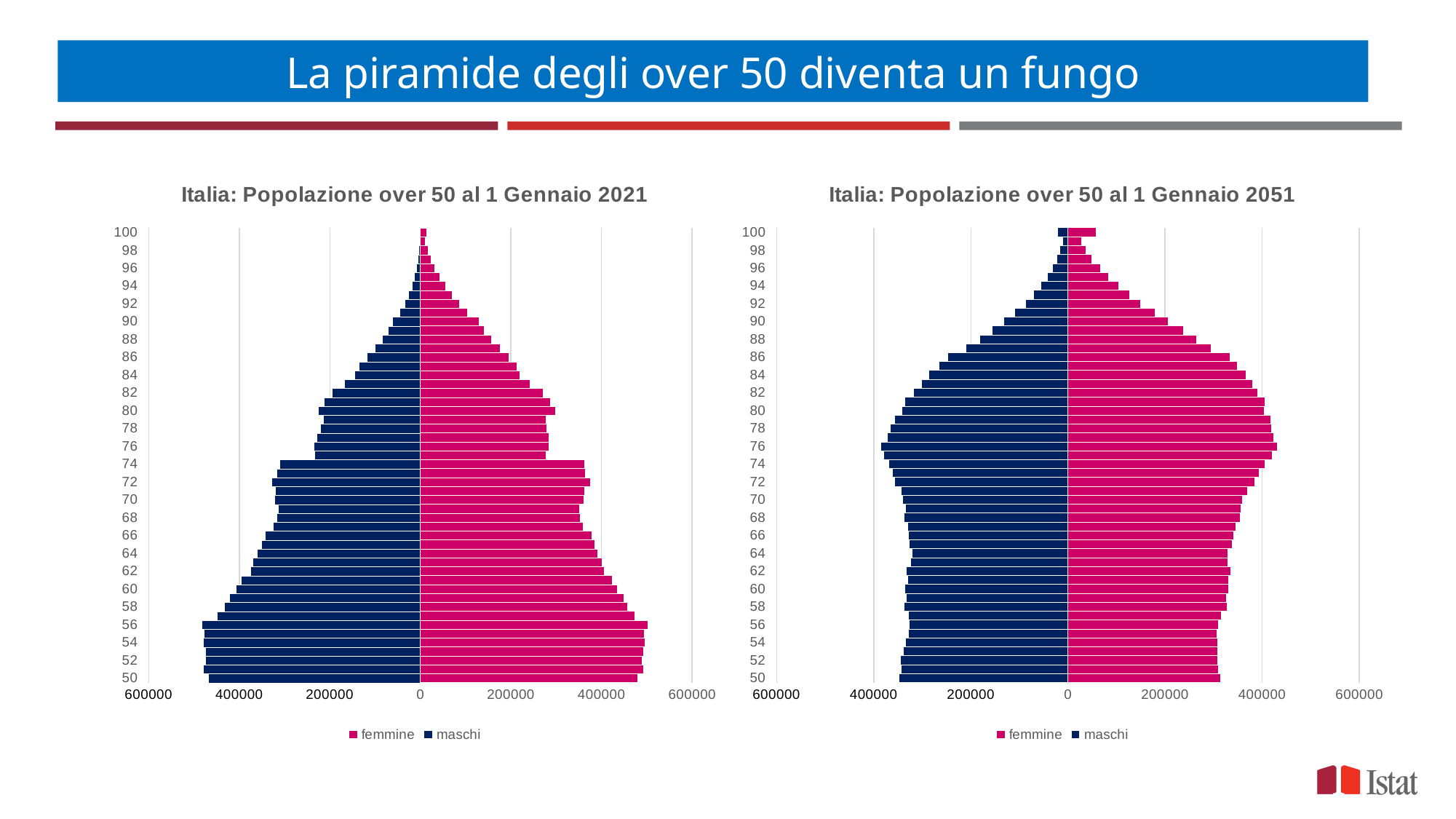
In the right chart (2051), is the value for femmine at age 76 greater or less than 400000? greater In the right chart (2051), is the value for maschi at age 60 greater or less than 400000? less In the left chart (2021), which age has the longest femmine bar? 56 In the left chart (2021), do the maschi bars get longer or shorter as age increases from 76 to 100? shorter In the right chart (2051), at age 90, which is larger: femmine or maschi? femmine In the right chart (2051), which age has the longest femmine bar? 76 How many series does the legend of the right chart, 'Italia: Popolazione over 50 al 1 Gennaio 2051', list? 2 In the left chart (2021), is the value for maschi at age 90 greater or less than 200000? less What are the two series named in the legend of the left chart (2021)? femmine and maschi What kind of chart is the left chart, 'Italia: Popolazione over 50 al 1 Gennaio 2021'? bar chart In the left chart (2021), at age 80, which is larger: femmine or maschi? femmine